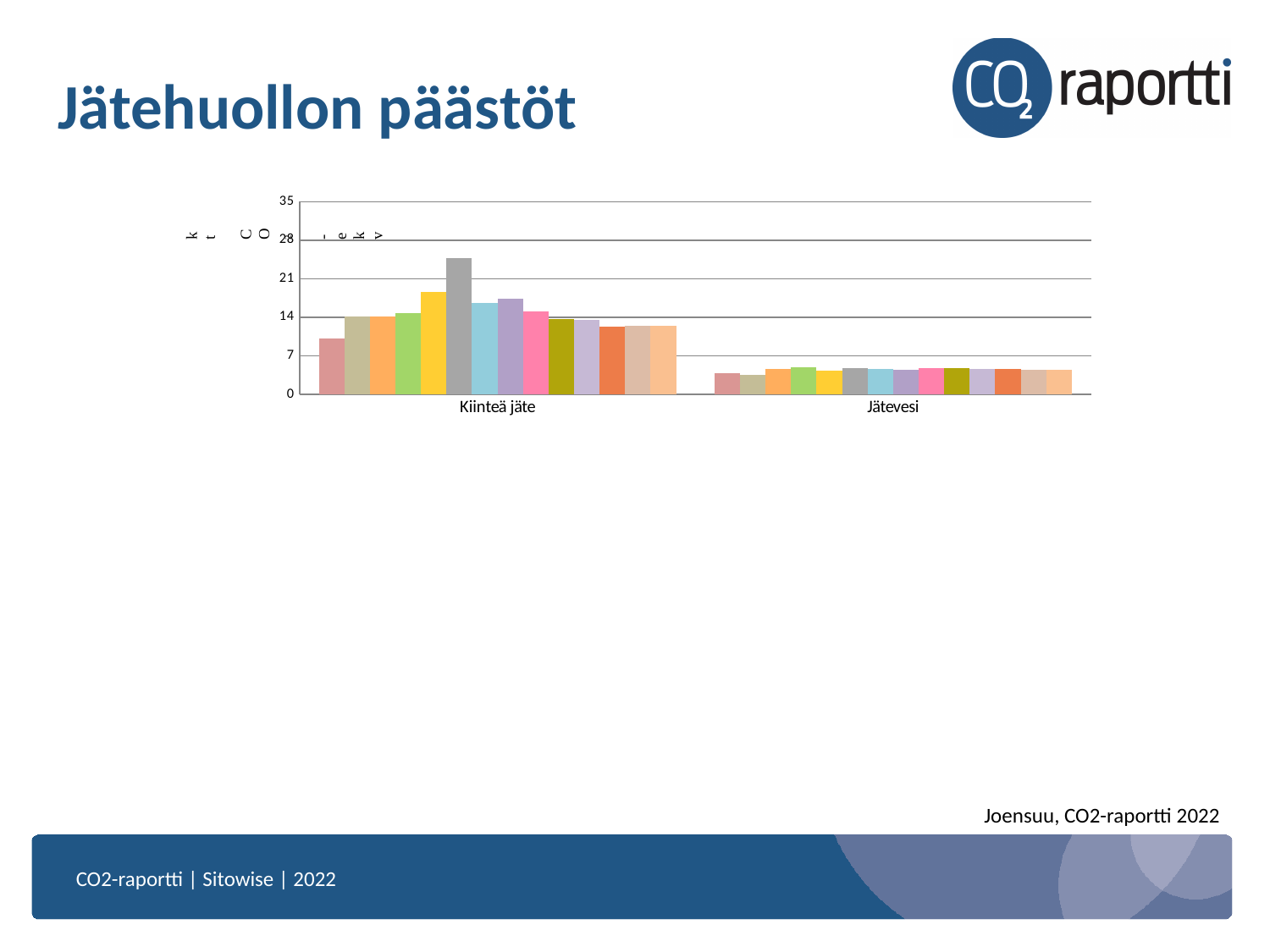
Is the first (leftmost) bar in the Kiinteä jäte category greater or less than 14? less How many categories are shown on the x axis of the chart? 2 Is the tallest bar in the Kiinteä jäte category greater or less than 21? greater What kind of chart is shown on the slide? bar chart Which category has the higher bars, Kiinteä jäte or Jätevesi? Kiinteä jäte Are all the bars in the Jätevesi category greater or less than 7? less What is the highest value shown on the y axis of the chart? 35 Which category has the lowest values in the chart? Jätevesi What is the label of the right-hand category on the x axis? Jätevesi What is the title of the slide containing the chart? Jätehuollon päästöt